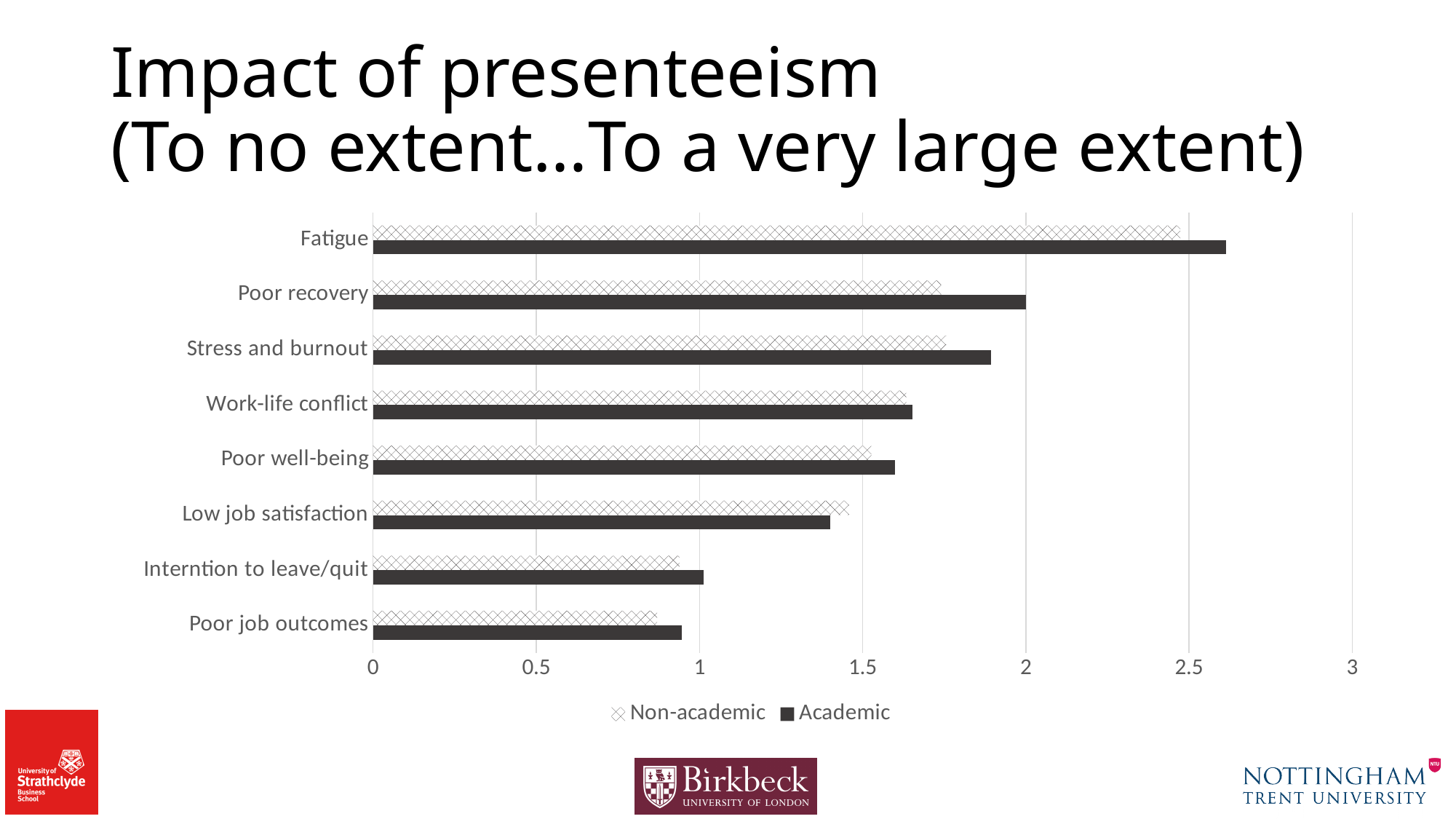
Which category has the lowest Academic value? Poor job outcomes How many series does the legend list? 2 What kind of chart is shown on the slide? bar chart Is the Academic value for Fatigue greater or less than 2.5? greater For Stress and burnout, which series has the larger value, Academic or Non-academic? Academic For Fatigue, which series has the larger value, Academic or Non-academic? Academic How many categories are plotted on the chart? 8 Is the Non-academic value for Low job satisfaction greater or less than 1.5? less Which category has the highest Academic value? Fatigue Which category has the lowest Non-academic value? Poor job outcomes Is the Academic value for Poor job outcomes greater or less than 1? less Which two series are listed in the legend? Non-academic and Academic